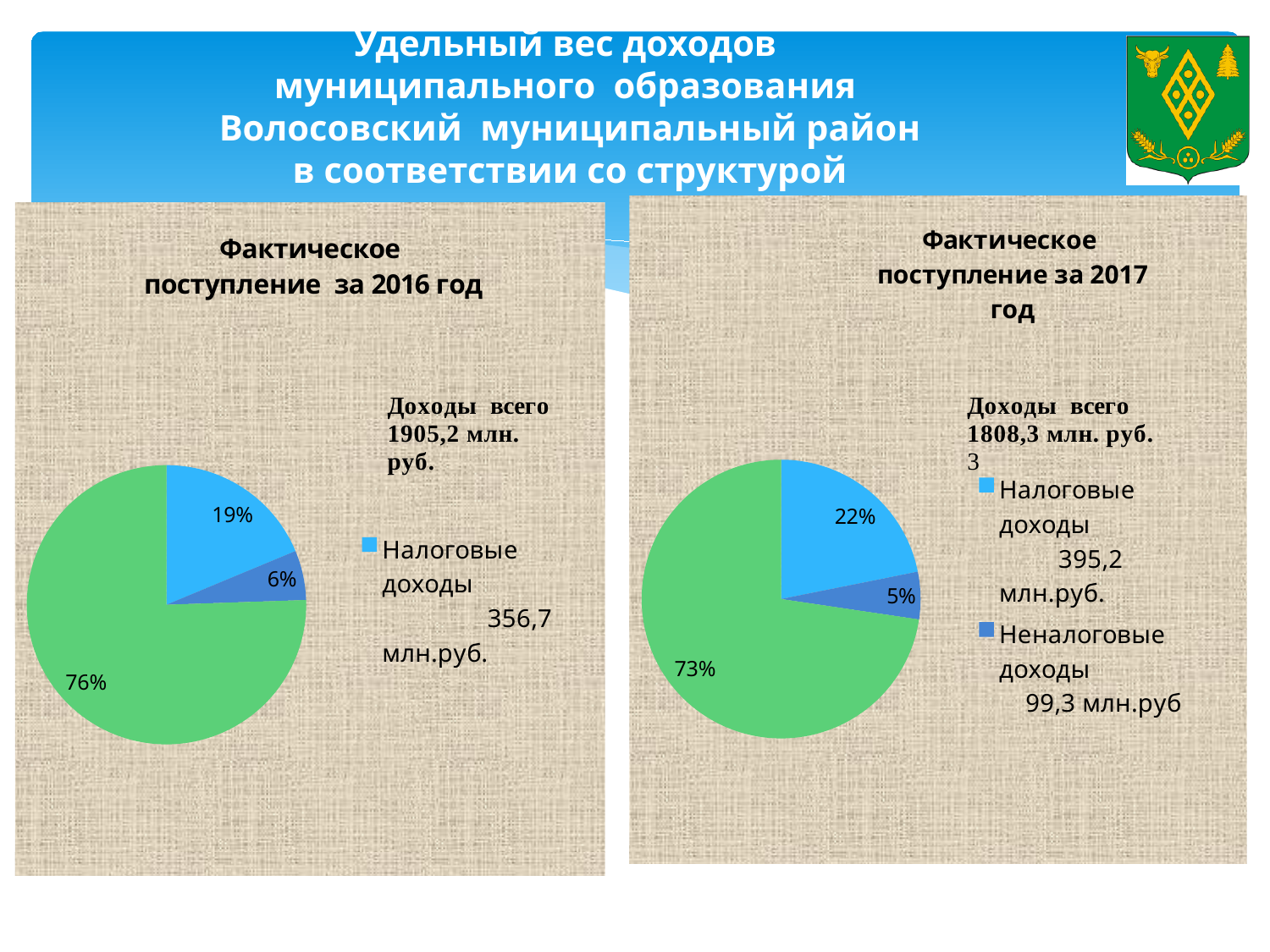
In the "Фактическое поступление за 2016 год" chart, what is the share of the smallest slice? 6% In the "Фактическое поступление за 2017 год" chart, what share is labelled for Неналоговые доходы? 5% In the "Фактическое поступление за 2017 год" chart, what amount in млн.руб. is given in the legend for Неналоговые доходы? 99,3 млн.руб In the "Фактическое поступление за 2016 год" chart, what share is labelled for Налоговые доходы? 19% By how many percentage points does the Налоговые доходы share in the 2017 chart exceed that in the 2016 chart? 3 In the "Фактическое поступление за 2017 год" chart, what share is labelled for Налоговые доходы? 22% In the "Фактическое поступление за 2016 год" chart, what is the share of the largest slice? 76% What kind of chart is shown under "Фактическое поступление за 2016 год"? pie chart How many slices does the "Фактическое поступление за 2017 год" pie chart have? 3 Is the share of Налоговые доходы larger in the 2016 chart or in the 2017 chart? 2017 In the "Фактическое поступление за 2017 год" chart, what is the share of the largest slice? 73%